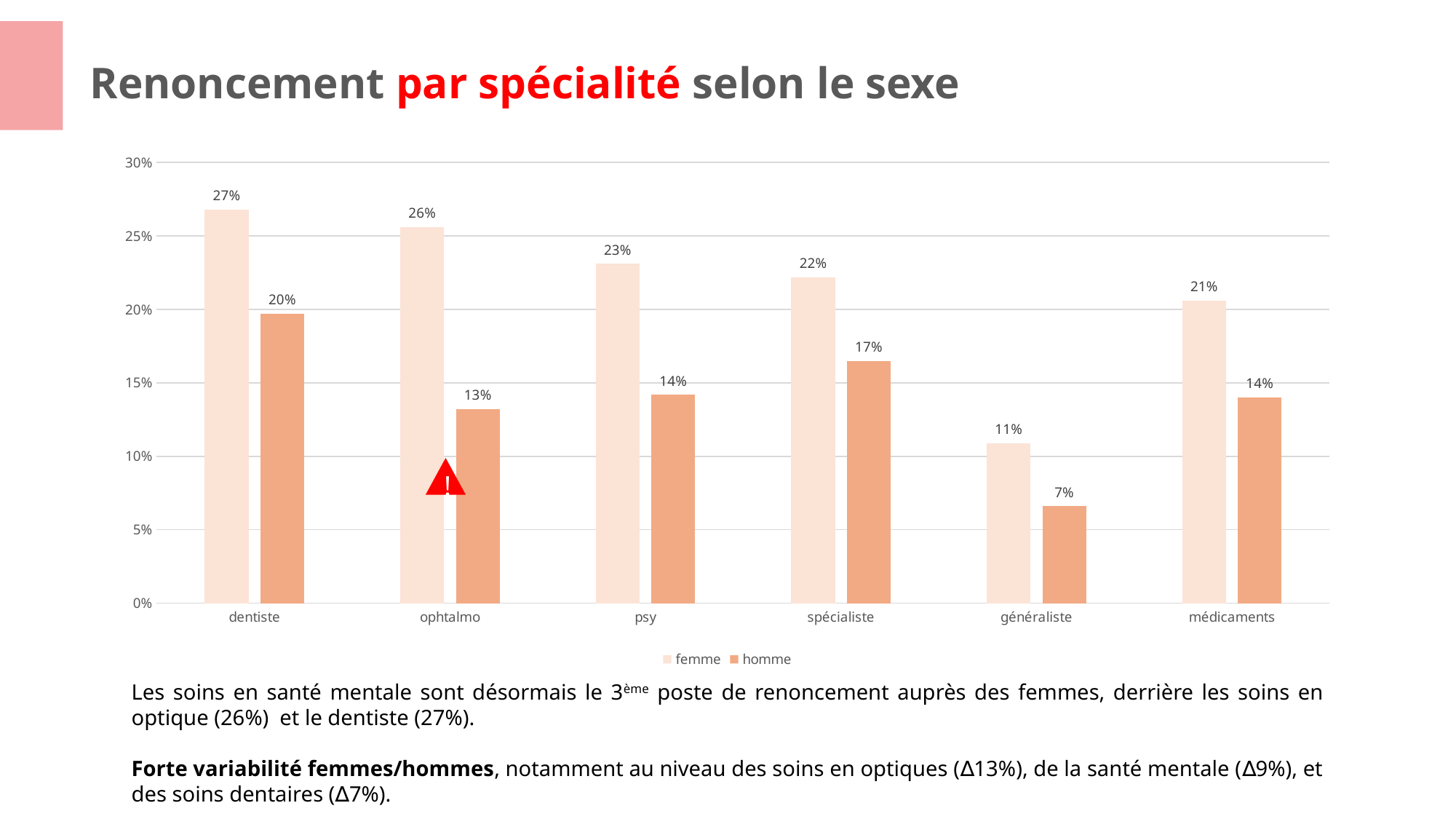
Which category has the highest value for femme? dentiste What is the value for femme in the médicaments category? 21% What are the two series named in the legend? femme and homme What is the value for femme in the dentiste category? 27% What is the difference between the femme and homme values for ophtalmo? 13% Which is larger for psy: the femme value or the homme value? femme How many series does the legend list? 2 What is the value for homme in the ophtalmo category? 13% How many categories are shown on the x axis? 6 Which category has the lowest value for homme? généraliste What kind of chart is shown on the slide? bar chart What is the value for homme in the généraliste category? 7%